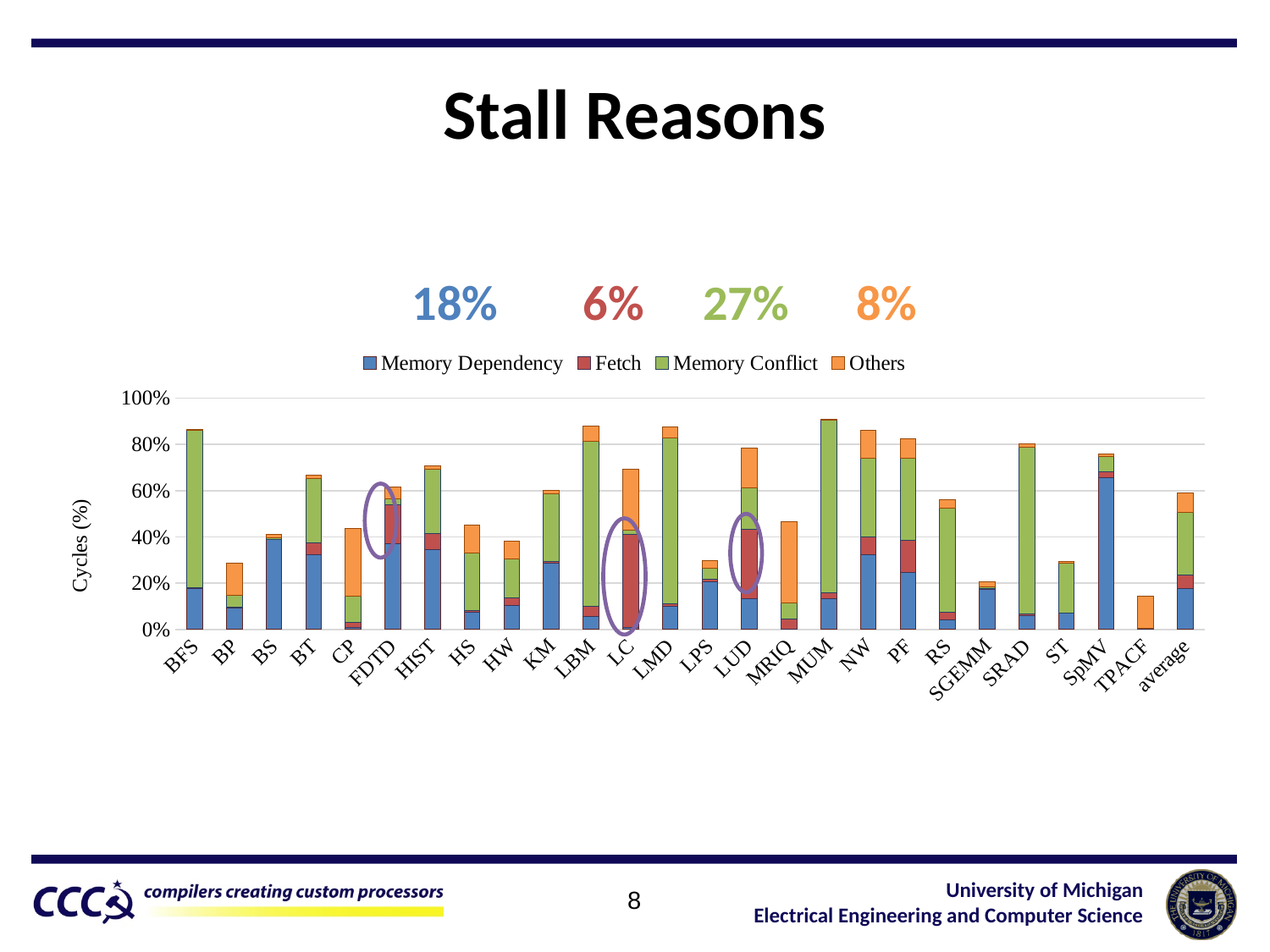
What is the label on the y axis? Cycles (%) How many categories are shown along the x axis? 26 What is the title of the chart? Stall Reasons How many series does the legend list? 4 Which has the larger Memory Dependency value, SpMV or BS? SpMV Is the total stacked value for MUM greater or less than 80%? greater Which has the larger total stacked bar, BFS or BP? BFS Is the Memory Dependency value for SpMV greater or less than 60%? greater What kind of chart is shown on the slide? Stacked bar chart Is the total stacked value for TPACF greater or less than 20%? less Which category has the lowest total stacked bar? TPACF